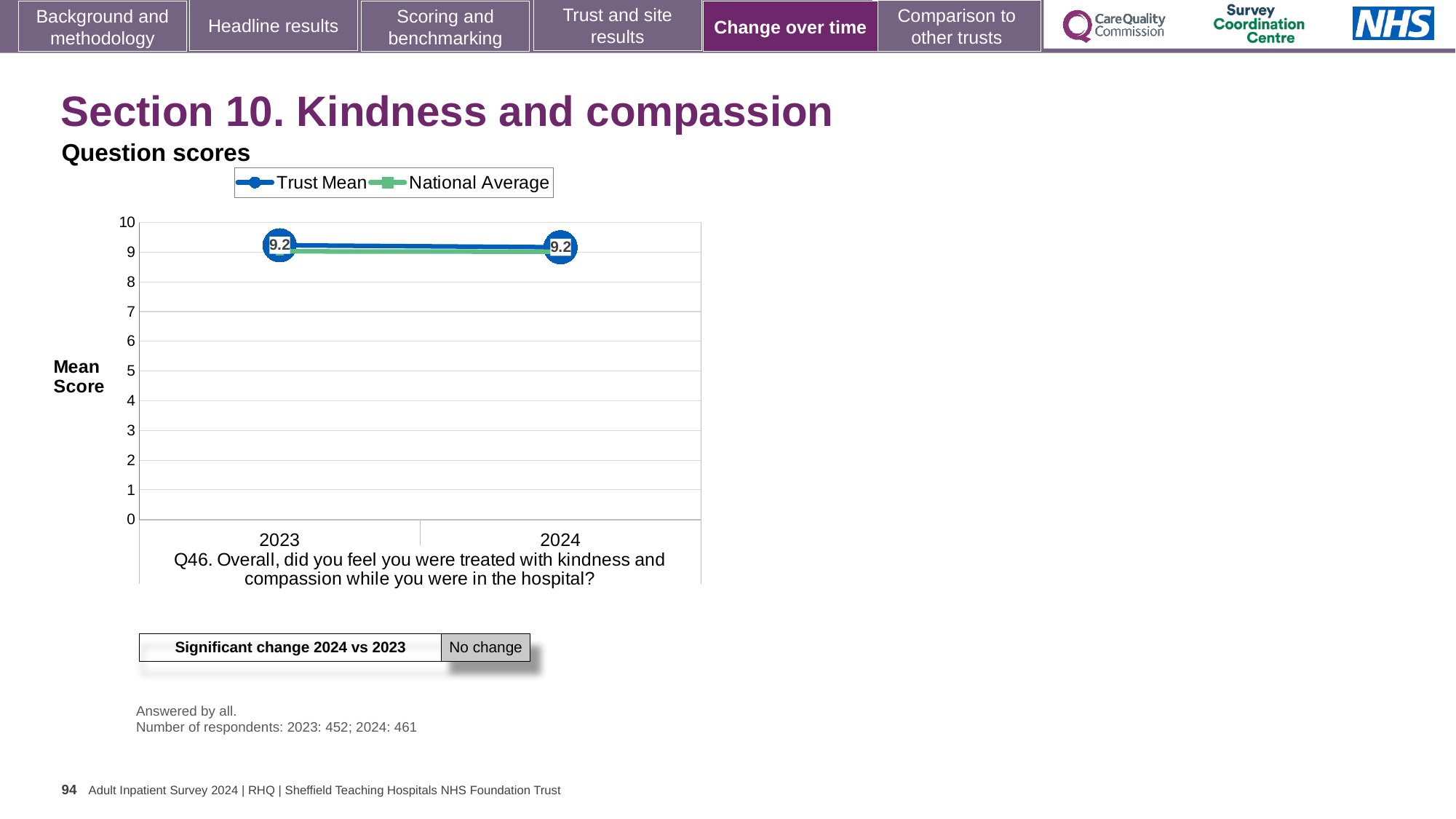
What is the label on the y axis of the chart? Mean Score What kind of chart is shown on the slide? Line chart How many years are plotted on the x axis of the chart? 2 Which two series are listed in the chart legend? Trust Mean and National Average Is the National Average value for 2024 greater or less than 10? less What is the Trust Mean value for 2023? 9.2 How many series does the chart legend list? 2 Is the National Average value for 2023 greater or less than 8? greater What is the Trust Mean value for 2024? 9.2 What is the difference between the Trust Mean in 2024 and the Trust Mean in 2023? 0 Does the Trust Mean rise, fall or stay the same from 2023 to 2024? Stays the same